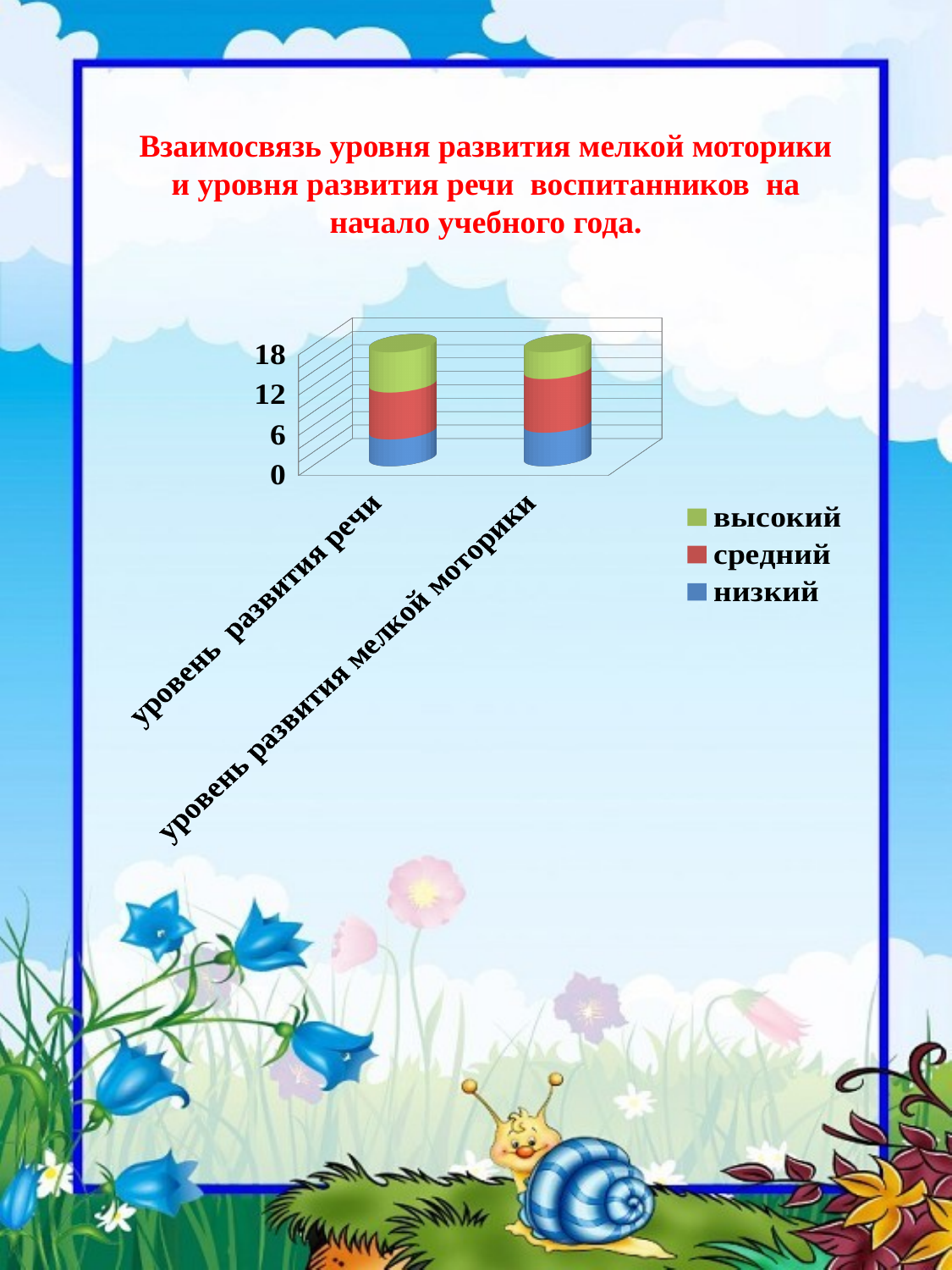
Which category has the larger "высокий" segment: "уровень развития речи" or "уровень развития мелкой моторики"? уровень развития речи Is the "низкий" segment of the bar for "уровень развития речи" greater or less than 12? less What kind of chart is shown on the slide? bar chart Which series is shown in blue in the chart? низкий Which category has the larger "средний" segment: "уровень развития речи" or "уровень развития мелкой моторики"? уровень развития мелкой моторики How many categories are shown on the x axis of the chart? 2 What is the title of the slide containing the chart? Взаимосвязь уровня развития мелкой моторики и уровня развития речи воспитанников на начало учебного года. What are the three series listed in the chart's legend? высокий, средний, низкий Is the total height of the stacked bar for "уровень развития мелкой моторики" greater or less than 12? greater How many series does the chart's legend list? 3 Is the total height of the stacked bar for "уровень развития речи" greater or less than 12? greater